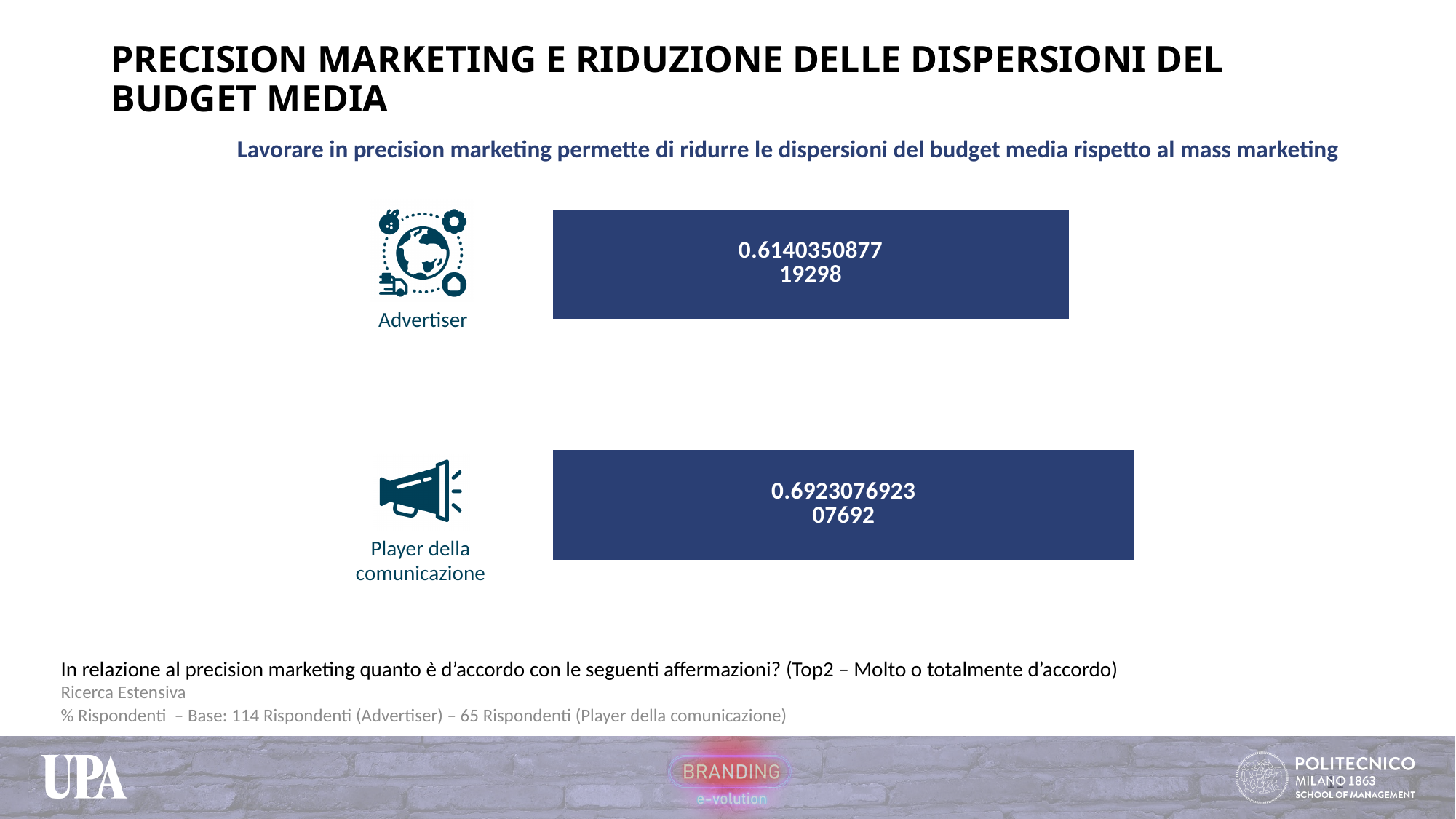
What statement is the chart measuring agreement with? Lavorare in precision marketing permette di ridurre le dispersioni del budget media rispetto al mass marketing What is the difference between the value for Player della comunicazione and the value for Advertiser? 0.078272604588394 What value is shown on the bar for Player della comunicazione? 0.692307692307692 Is the value for Advertiser larger or smaller than the value for Player della comunicazione? smaller What value is shown on the bar for Advertiser? 0.614035087719298 Which category has the higher value? Player della comunicazione What colour are the bars in the chart? dark blue Which category has the lower value? Advertiser How many categories are plotted in the chart? 2 What kind of chart is shown on the slide? bar chart